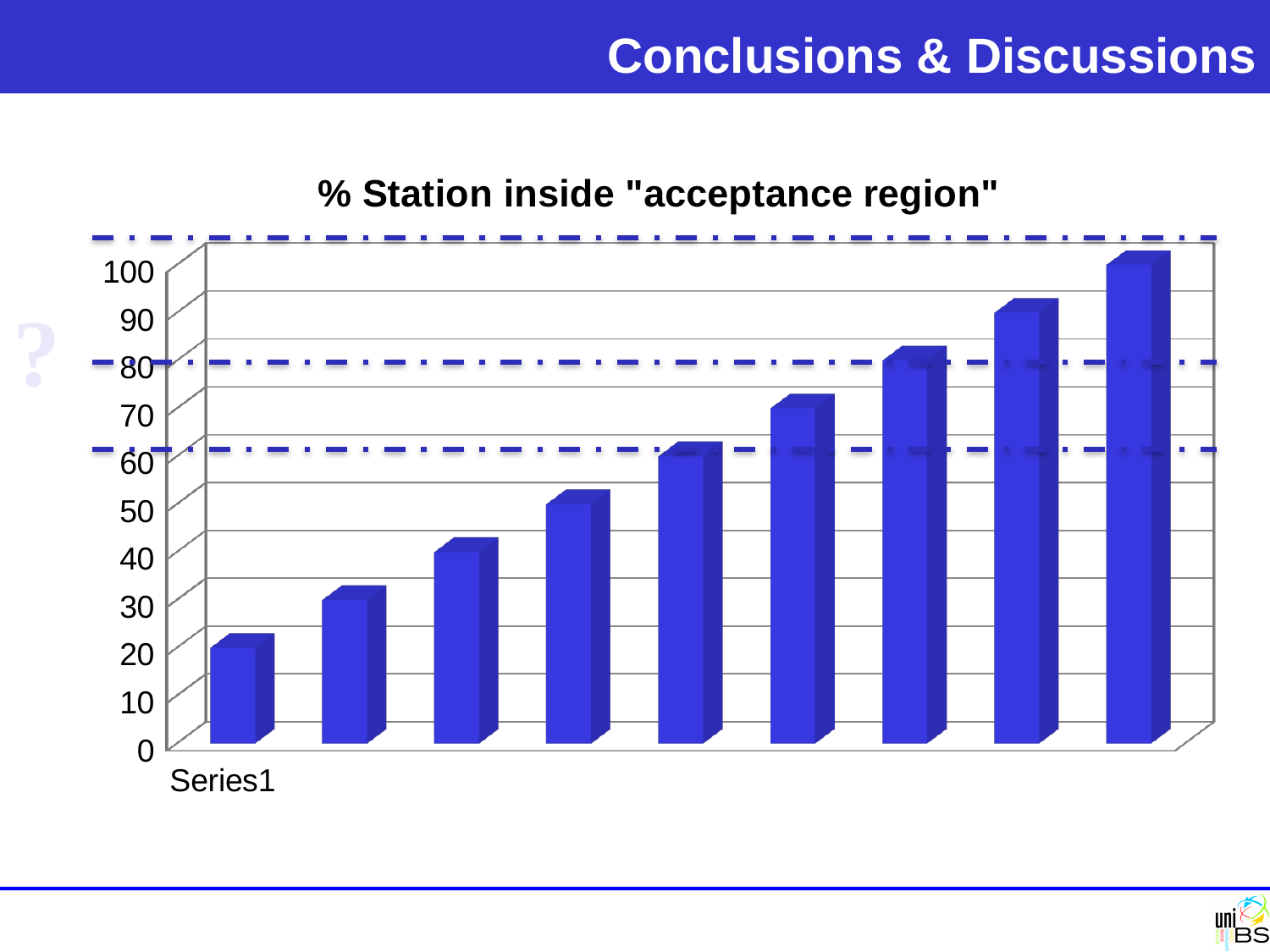
What value does the leftmost bar reach on the y axis? 20 Do the bar values rise or fall from left to right across the chart? rise What is the title of the chart? % Station inside "acceptance region" How many bars are plotted in the chart? 9 What kind of chart is shown on the slide? bar chart Which bar is the shortest in the chart? the leftmost bar Which bar is the tallest in the chart? the rightmost bar Is the value of the fourth bar from the left greater or less than 60? less What value does the rightmost bar reach on the y axis? 100 What label appears on the x axis below the first bar? Series1 Which is taller, the third bar from the left or the sixth bar from the left? the sixth bar from the left Is the value of the seventh bar from the left greater or less than 70? greater